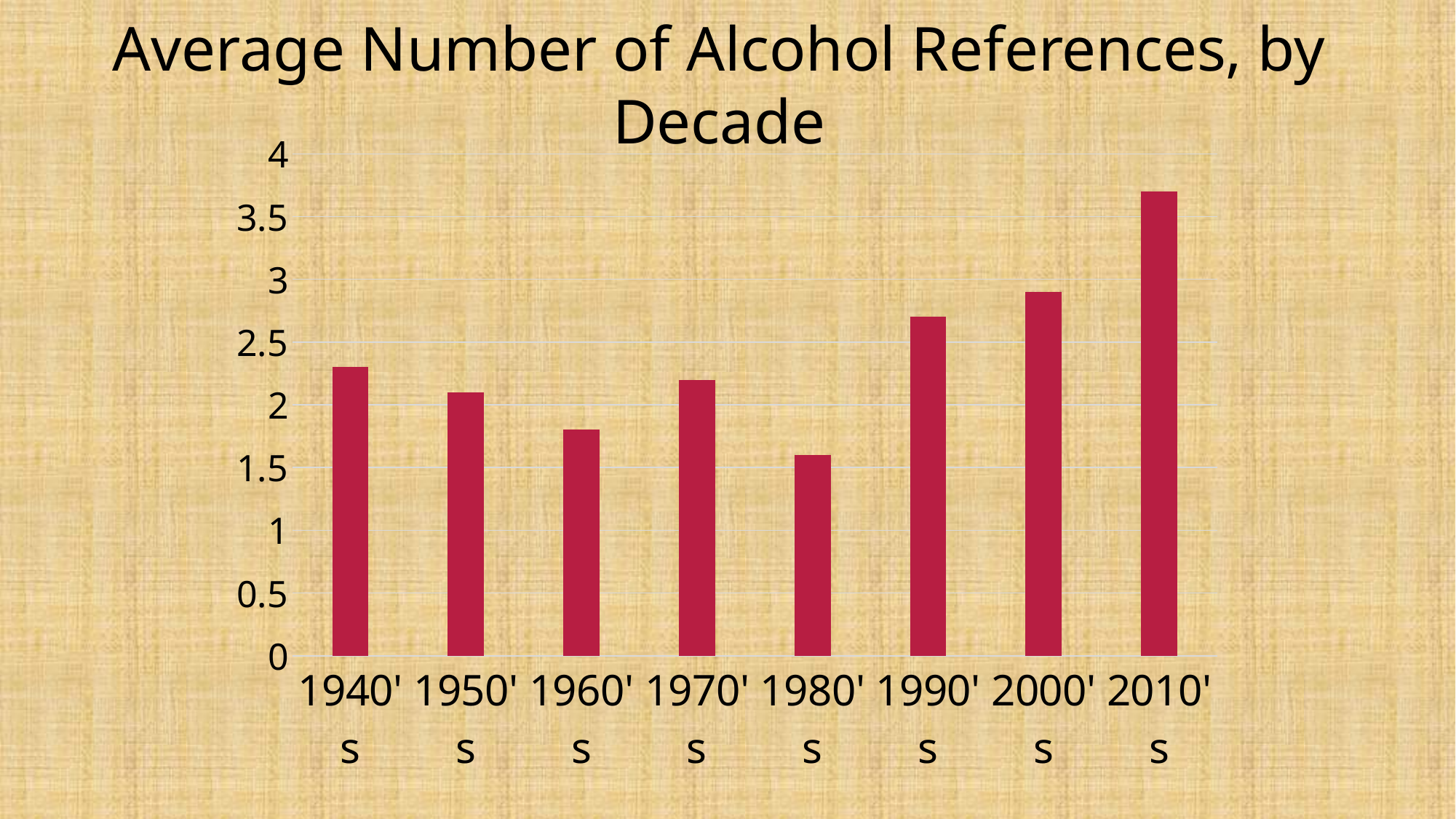
Which is larger, the value for the 1940's or the value for the 1980's? 1940's Is the value for the 1960's greater or less than 2? less Which is larger, the value for the 1990's or the value for the 1970's? 1990's Is the value for the 2010's greater or less than 3.5? greater What kind of chart is shown on the slide? bar chart What is the title of the chart? Average Number of Alcohol References, by Decade Which decade has the lowest average number of alcohol references? 1980's Do the values rise or fall from the 1980's to the 2010's? rise How many decades are plotted on the chart? 8 Which decade has the highest average number of alcohol references? 2010's Is the value for the 2000's greater or less than 3? less